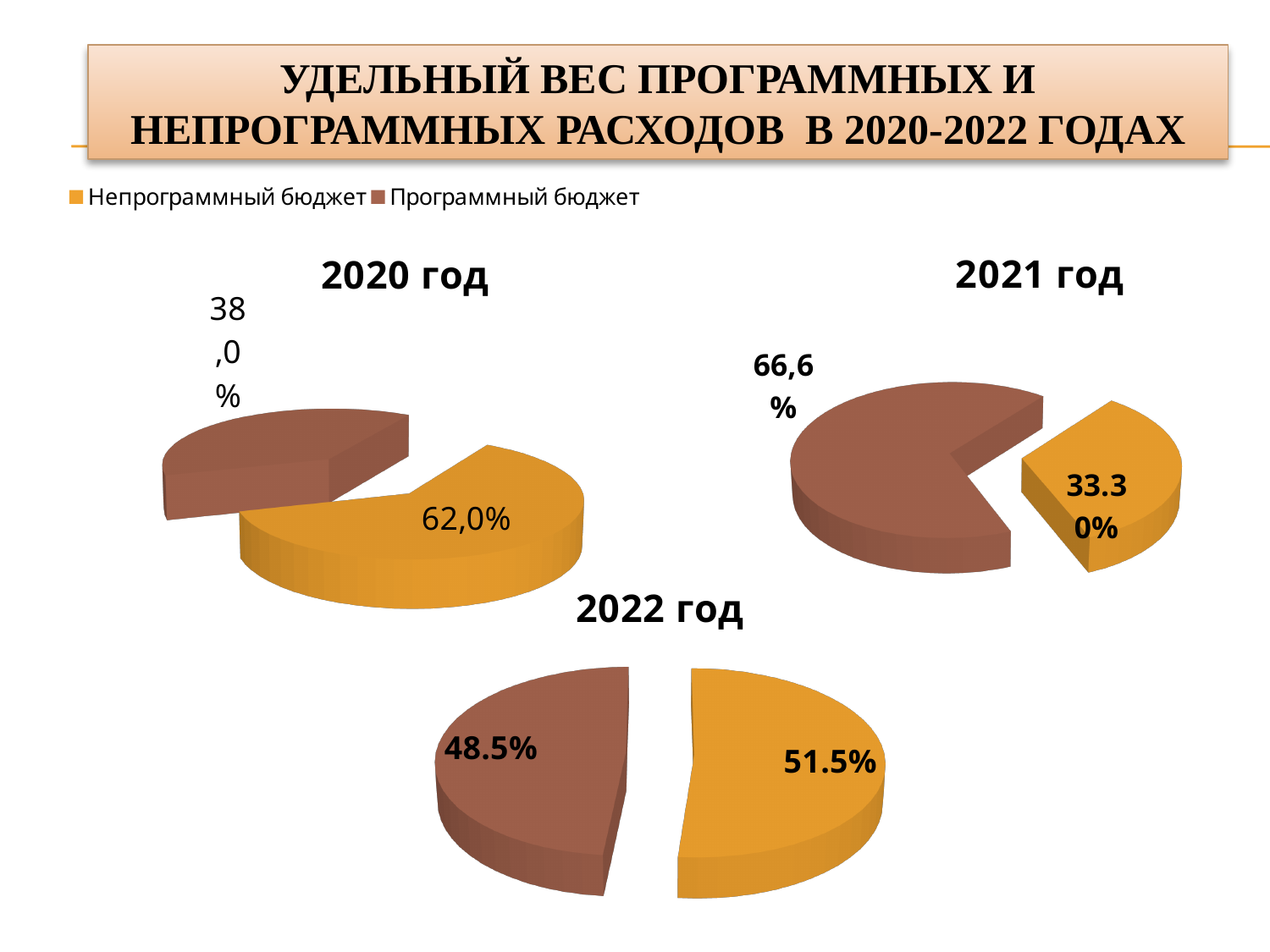
How many series does the legend list? 2 In the 2022 год chart, what is the value of the orange slice (Непрограммный бюджет)? 51.5% In the 2022 год chart, what is the value of the brown slice (Программный бюджет)? 48.5% In the 2020 год chart, what is the value of the brown slice (Программный бюджет)? 38,0% In the 2021 год chart, what is the value of the orange slice (Непрограммный бюджет)? 33.30% How many pie charts are on the slide? 3 In the 2021 год chart, what is the value of the brown slice (Программный бюджет)? 66,6% What kind of charts are shown on the slide? pie charts In the 2020 год chart, what is the difference between the orange slice and the brown slice? 24,0% In the 2021 год chart, which slice is larger, the brown one or the orange one? the brown one (Программный бюджет) In the 2020 год chart, what is the value of the orange slice (Непрограммный бюджет)? 62,0% Which colour represents Программный бюджет in the legend? brown